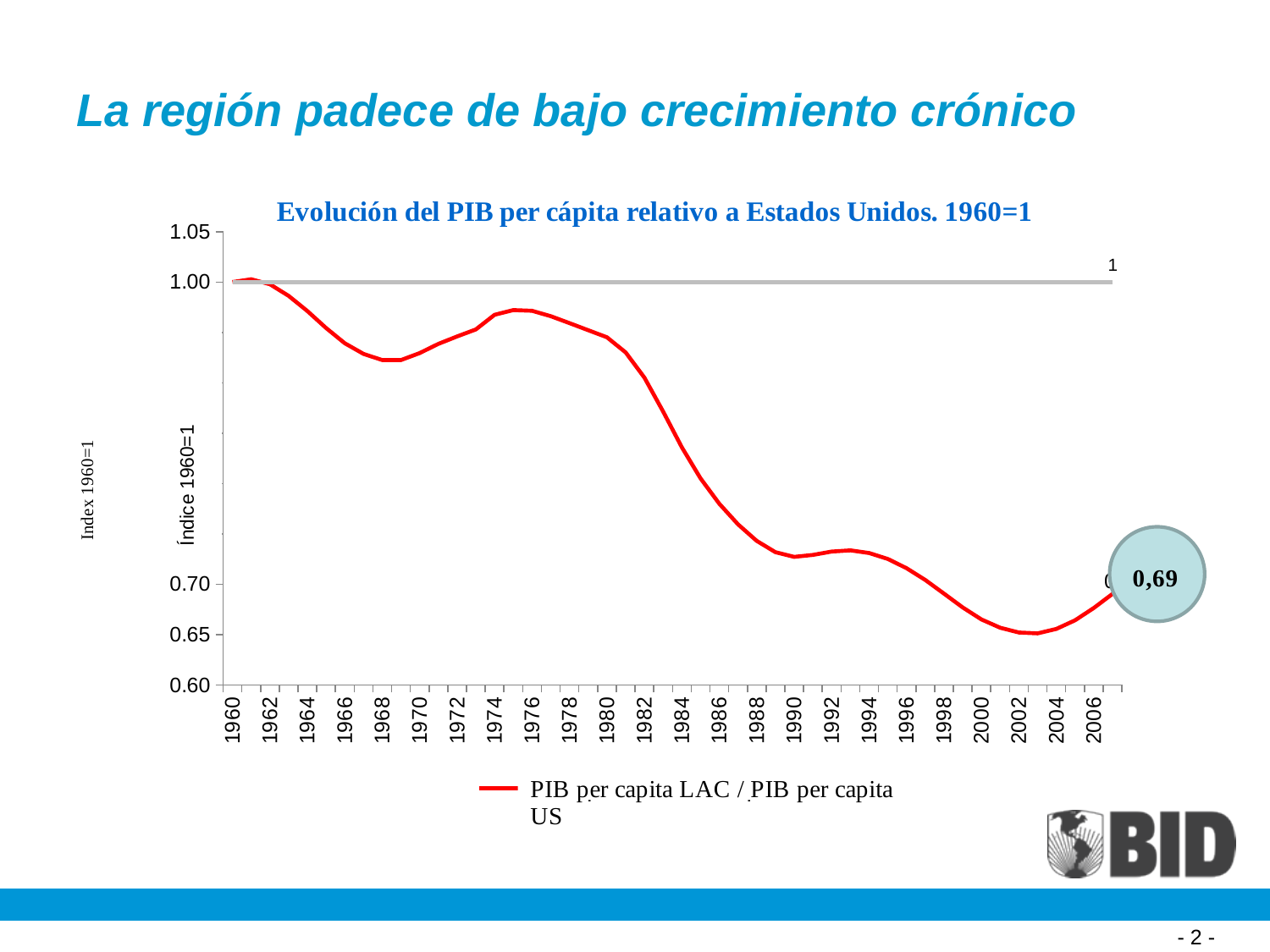
What series does the legend list for the red line? PIB per capita LAC / PIB per capita US What value is highlighted in the circle at the end of the red line? 0,69 What value is labelled on the flat gray reference line? 1 Which is larger, the red line's value in 1975 or in 1990? 1975 What is the title of the chart? Evolución del PIB per cápita relativo a Estados Unidos. 1960=1 How many series does the legend list? 1 What is the first year shown on the x axis? 1960 Which is larger, the red line's value in 1960 or in 2006? 1960 Does the red line overall rise or fall from 1960 to 2006? fall What kind of chart is shown on the slide? line chart Is the value of the red line in 1968 greater or less than 1.00? less Is the value of the red line in 1984 greater or less than 0.70? greater